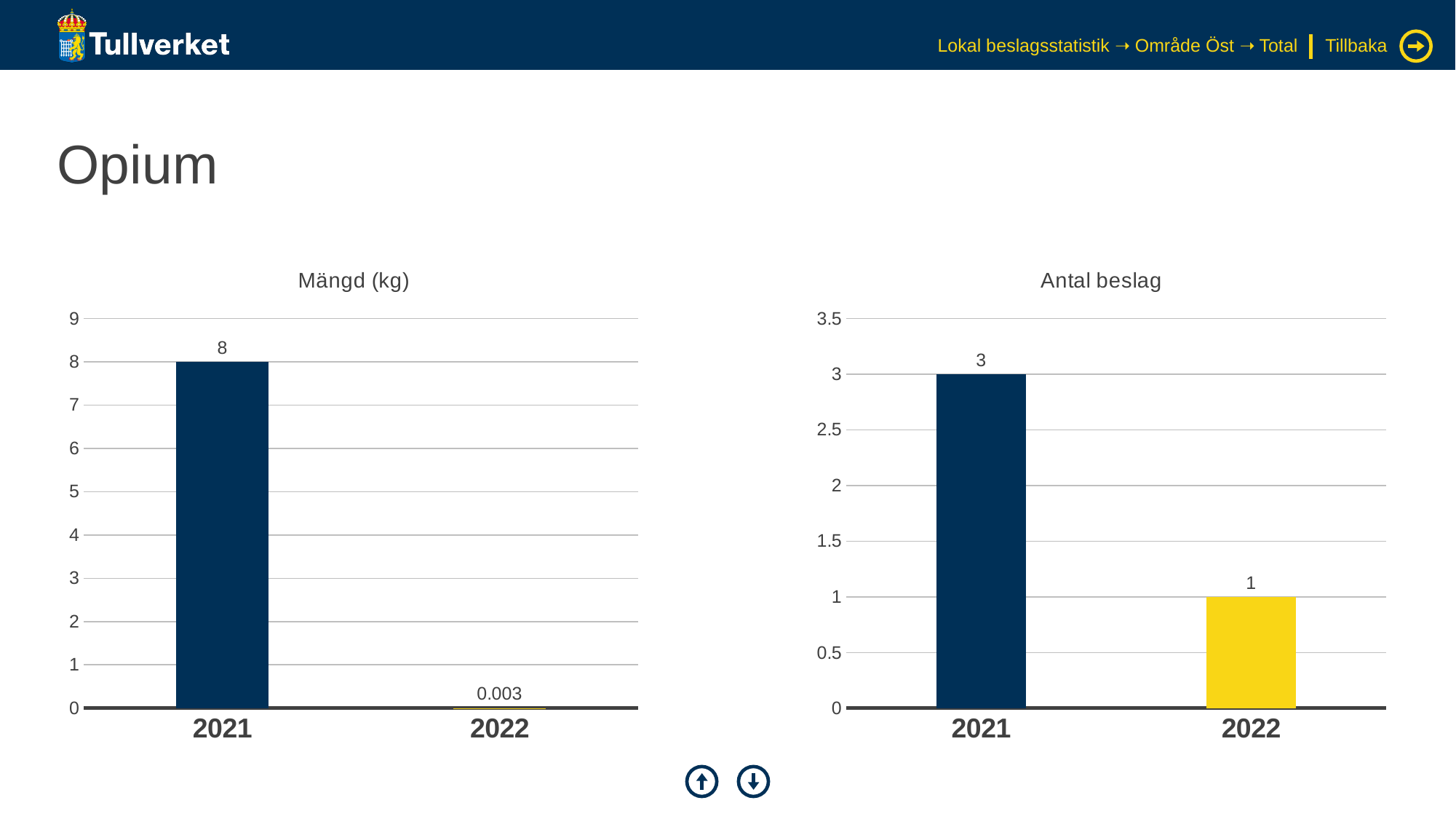
In the 'Antal beslag' chart, what is the difference between the values for 2021 and 2022? 2 In the 'Antal beslag' chart, what is the value for 2022? 1 In the 'Mängd (kg)' chart, what is the value for 2022? 0.003 In the 'Mängd (kg)' chart, what is the value for 2021? 8 In the 'Antal beslag' chart, which year has the highest value? 2021 What kind of chart is the 'Mängd (kg)' chart? bar chart In the 'Antal beslag' chart, do the values rise or fall from 2021 to 2022? fall In the 'Mängd (kg)' chart, which year has the lowest value? 2022 In the 'Antal beslag' chart, what is the value for 2021? 3 What is the title of the chart on the right side of the slide? Antal beslag How many categories are shown on the x axis of the 'Antal beslag' chart? 2 In the 'Mängd (kg)' chart, which is larger, the value for 2021 or the value for 2022? 2021